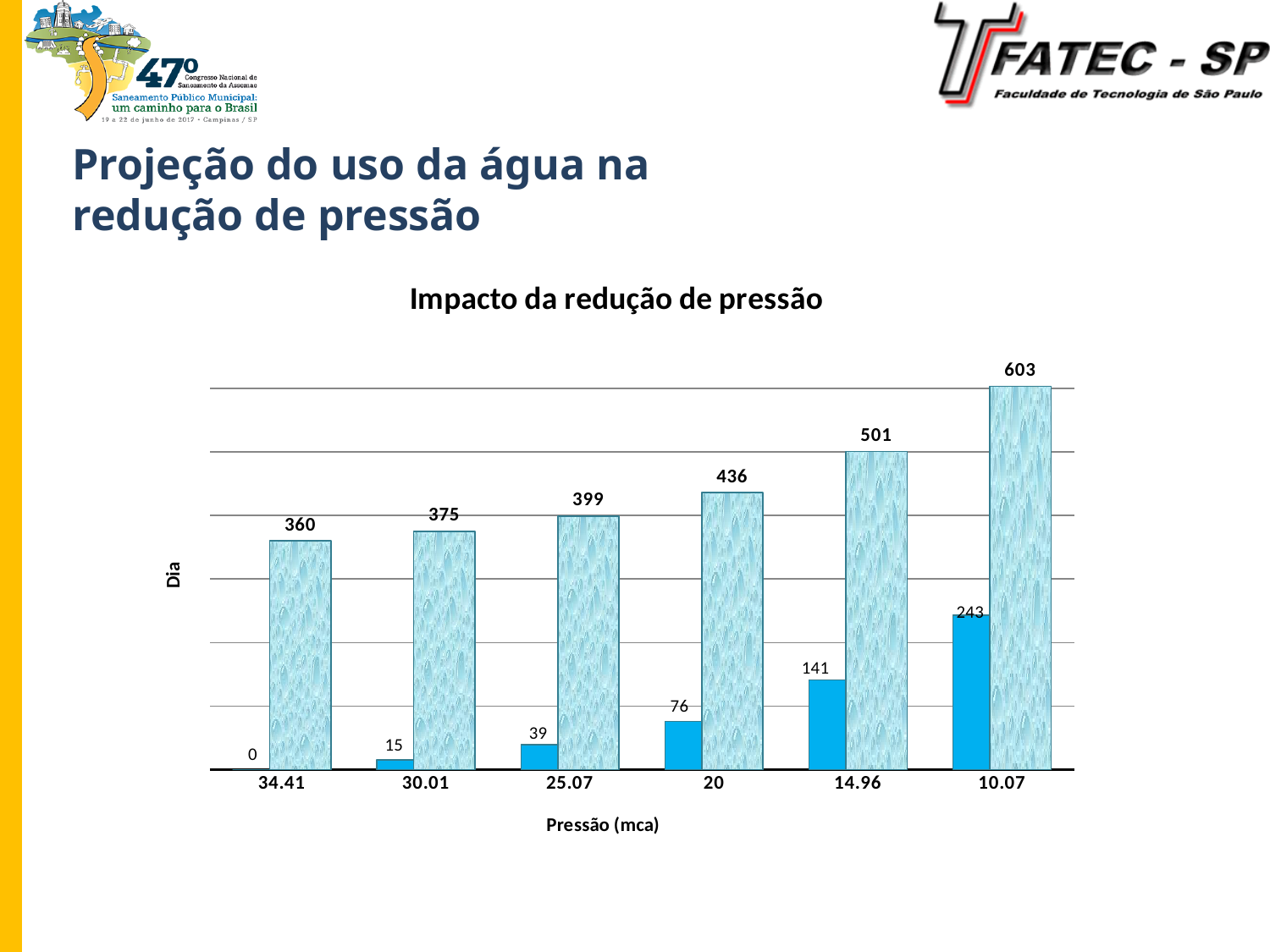
What is the value of the textured light blue bar at pressure 10.07 mca? 603 How many pressure categories are shown on the x axis of the chart? 6 What type of chart is shown on the slide? bar chart Which is larger: the solid dark blue bar at 20 mca or the solid dark blue bar at 30.01 mca? 20 mca What is the value of the textured light blue bar at pressure 34.41 mca? 360 Do the textured light blue bar values rise or fall moving from left to right along the x axis? rise What is the value of the solid dark blue bar at pressure 14.96 mca? 141 What is the title of the chart? Impacto da redução de pressão What is the difference between the textured light blue bar values at 10.07 mca and 34.41 mca? 243 At which pressure is the textured light blue bar lowest? 34.41 What is the value of the solid dark blue bar at pressure 25.07 mca? 39 At which pressure is the solid dark blue bar highest? 10.07